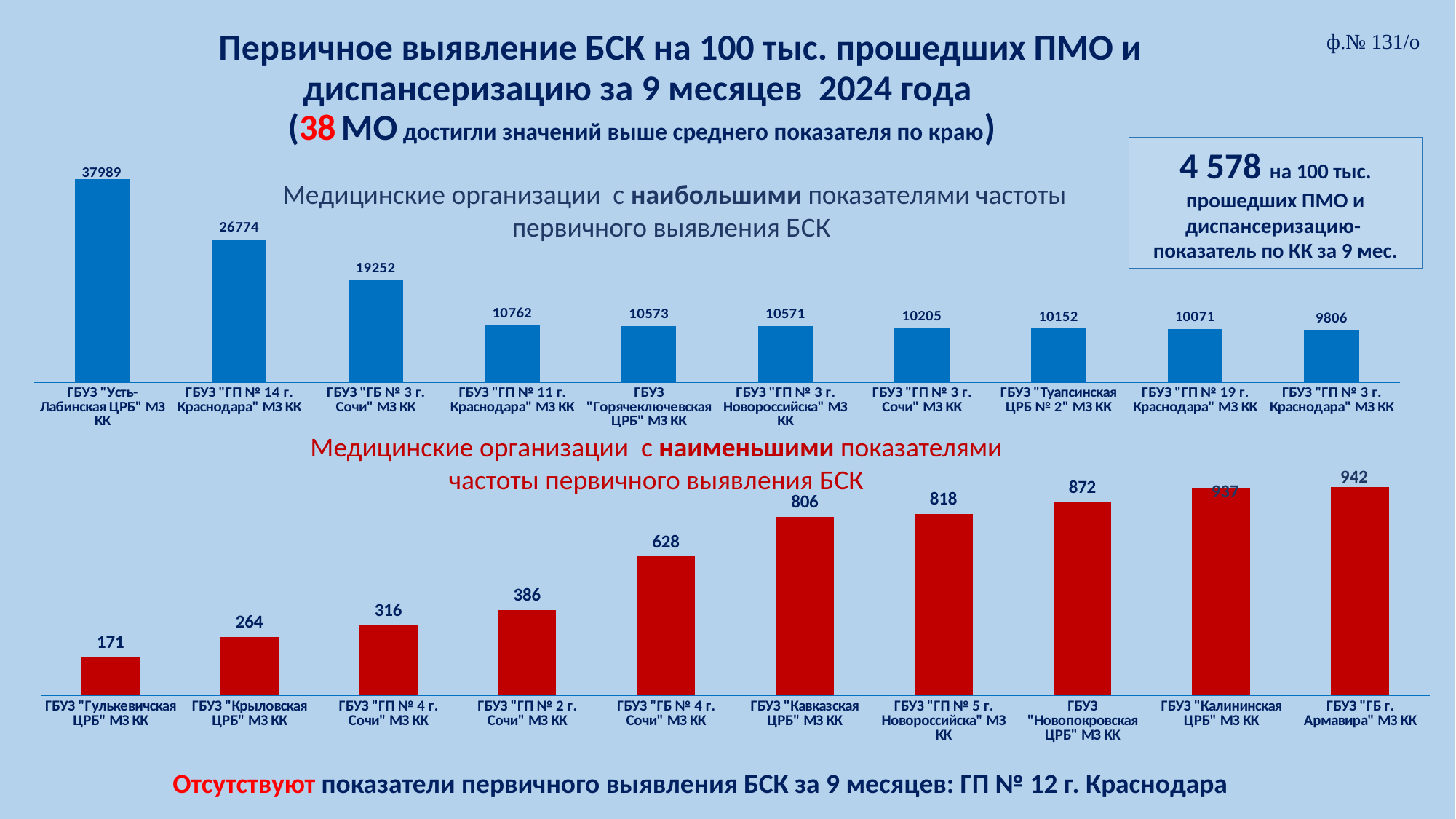
What type of chart is the bottom chart (organizations with the lowest rates)? bar chart On the bottom chart (organizations with the lowest rates), what is the value for ГБУЗ "Гулькевичская ЦРБ" МЗ КК? 171 On the bottom chart (organizations with the lowest rates), what is the difference between ГБУЗ "Крыловская ЦРБ" МЗ КК and ГБУЗ "Гулькевичская ЦРБ" МЗ КК? 93 On the bottom chart (organizations with the lowest rates), which organization has the highest value? ГБУЗ "ГБ г. Армавира" МЗ КК On the bottom chart (organizations with the lowest rates), do the values rise or fall from left to right? rise On the top chart (organizations with the highest rates), what is the difference between ГБУЗ "Усть-Лабинская ЦРБ" МЗ КК and ГБУЗ "ГП № 14 г. Краснодара" МЗ КК? 11215 On the top chart (organizations with the highest rates), which organization has the lowest value? ГБУЗ "ГП № 3 г. Краснодара" МЗ КК On the top chart (organizations with the highest rates), what is the value for ГБУЗ "ГБ № 3 г. Сочи" МЗ КК? 19252 On the top chart (organizations with the highest rates), what is the value for ГБУЗ "Усть-Лабинская ЦРБ" МЗ КК? 37989 On the bottom chart (organizations with the lowest rates), which is larger: the value for ГБУЗ "ГП № 2 г. Сочи" МЗ КК or ГБУЗ "ГБ № 4 г. Сочи" МЗ КК? ГБУЗ "ГБ № 4 г. Сочи" МЗ КК On the top chart (organizations with the highest rates), how many organizations are shown? 10 On the bottom chart (organizations with the lowest rates), what is the value for ГБУЗ "Кавказская ЦРБ" МЗ КК? 806